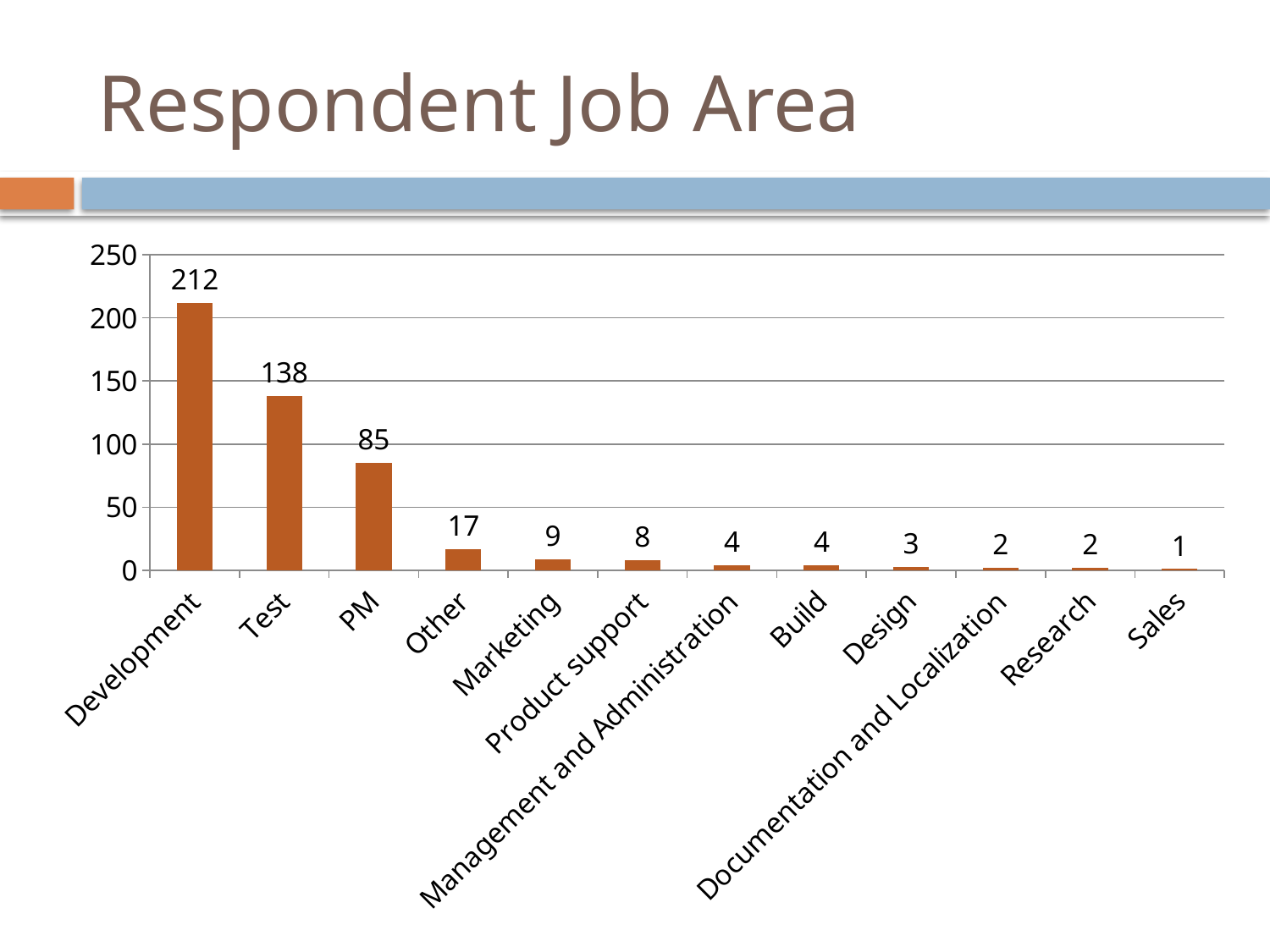
What is the value for PM? 85 Do the values rise or fall from left to right along the x axis? Fall Which is larger, the value for Marketing or the value for Product support? Marketing What is the difference between the values for Development and Test? 74 What is the difference between the values for Test and PM? 53 How many job area categories are shown on the chart? 12 Which job area has the lowest value? Sales Which job area has the highest value? Development What is the value for Documentation and Localization? 2 What is the value for Development? 212 What is the value for Other? 17 What kind of chart is shown on the slide? Bar chart